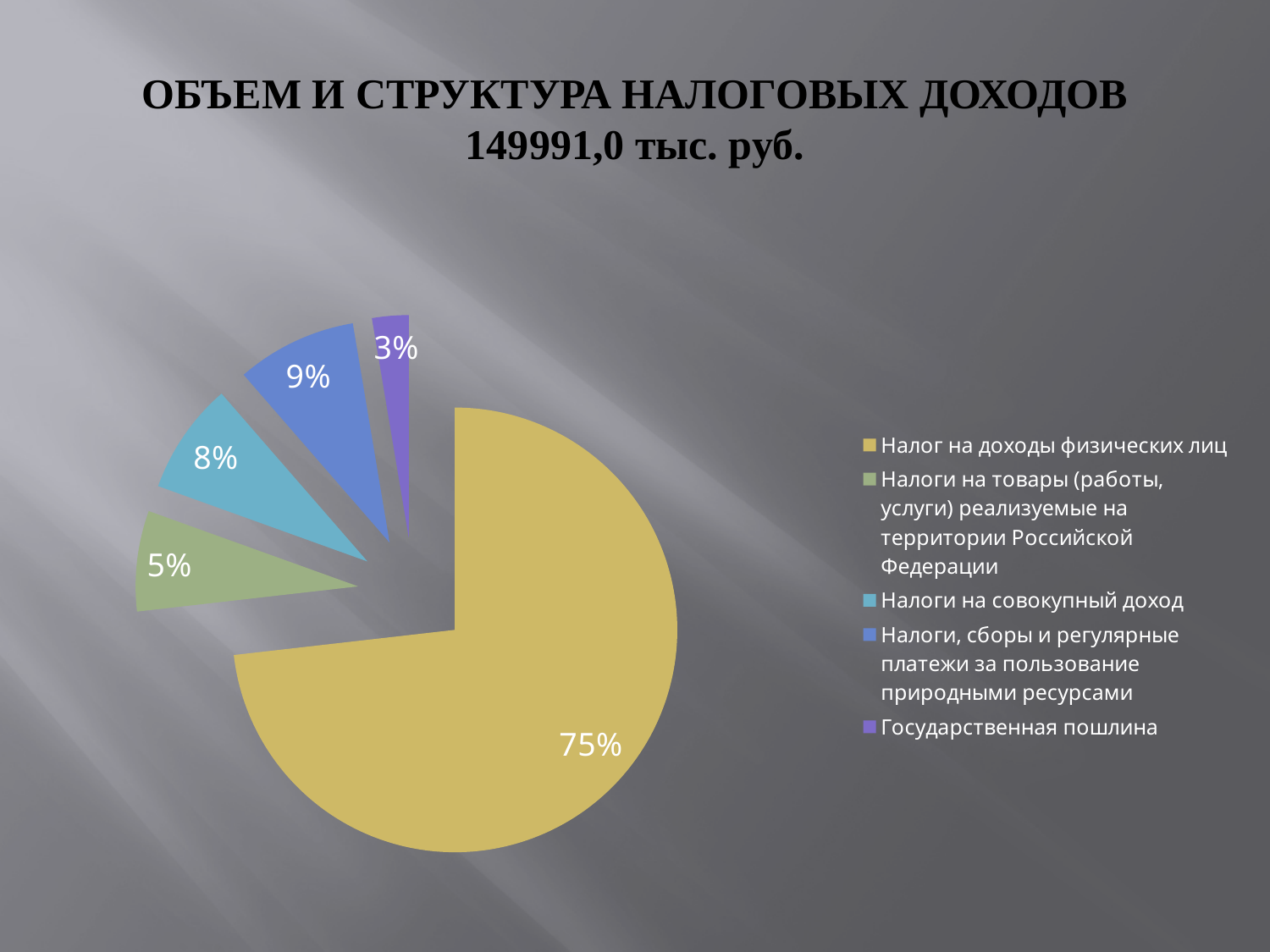
What share of the pie does "Налоги на совокупный доход" have? 8% What share of the pie does "Налоги, сборы и регулярные платежи за пользование природными ресурсами" have? 9% Which category has the smallest slice of the pie? Государственная пошлина What share of the pie does "Государственная пошлина" have? 3% Which is larger: the slice for "Налоги на совокупный доход" or the slice for "Налоги на товары (работы, услуги) реализуемые на территории Российской Федерации"? Налоги на совокупный доход What is the difference in percentage points between the slice for "Налог на доходы физических лиц" and the slice for "Налоги, сборы и регулярные платежи за пользование природными ресурсами"? 66 percentage points What kind of chart is shown on the slide? Pie chart Which category has the largest slice of the pie? Налог на доходы физических лиц What total amount of tax revenue is stated in the slide title? 149991,0 тыс. руб. How many slices does the pie chart have? 5